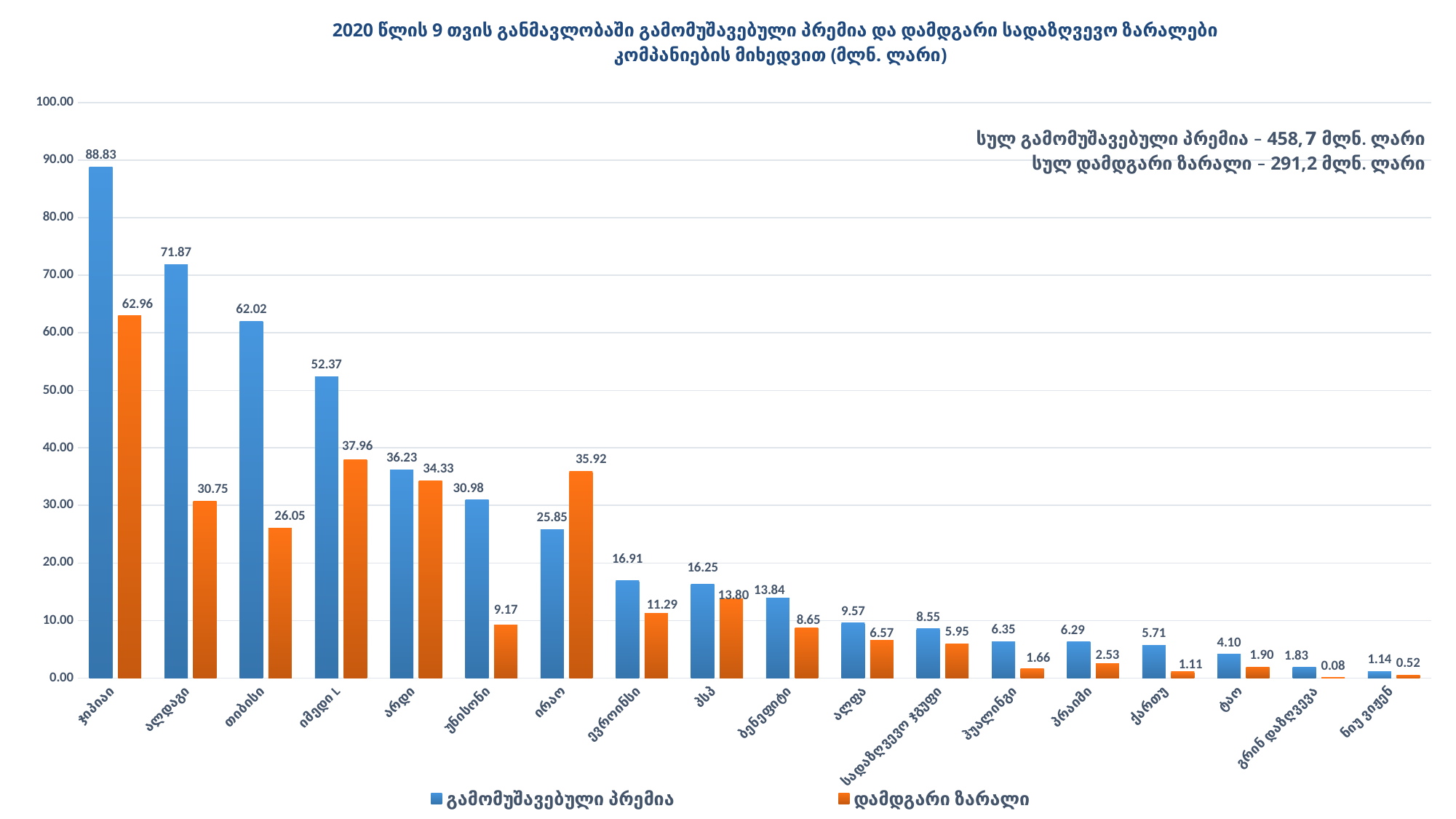
How many series does the legend list? 2 What is the difference between გამომუშავებული პრემია and დამდგარი ზარალი for ალდაგი? 41.12 What is the value of დამდგარი ზარალი for იმედი L? 37.96 For ირაო, which is larger: გამომუშავებული პრემია or დამდგარი ზარალი? დამდგარი ზარალი What kind of chart is shown on the slide? bar chart What is the value of გამომუშავებული პრემია for ჯიპიაი? 88.83 Which company has the highest გამომუშავებული პრემია? ჯიპიაი Is the value of გამომუშავებული პრემია for თიბისი greater or less than 60.00? greater Which company has the lowest დამდგარი ზარალი? გრინ დაზღვევა What is the value of დამდგარი ზარალი for ირაო? 35.92 Which colour represents დამდგარი ზარალი in the chart? orange How many companies are shown on the x axis? 18